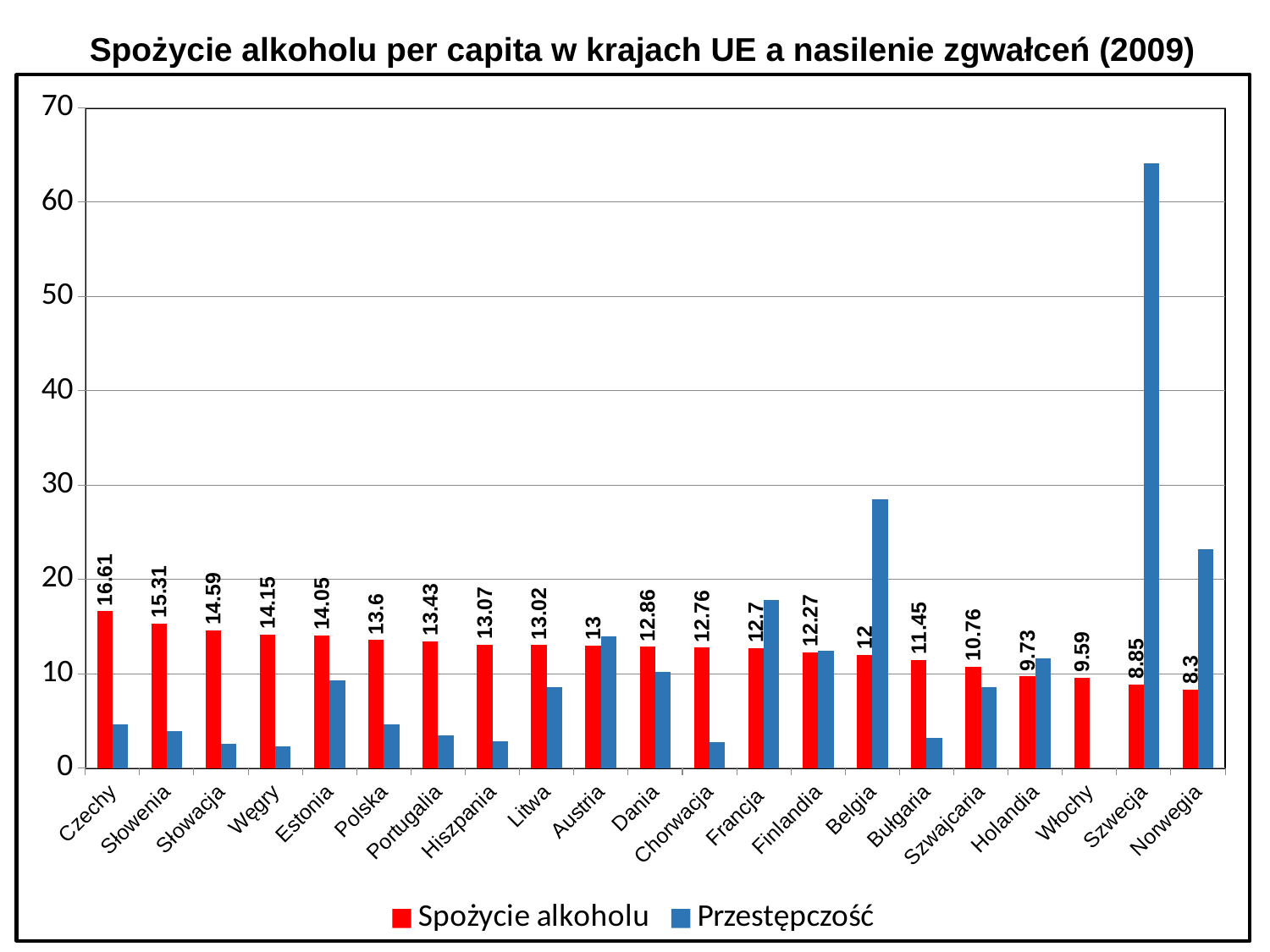
How many series does the legend list? 2 Is the Przestępczość value for Belgia greater or less than 20? greater What is the Spożycie alkoholu value for Czechy? 16.61 Which has a higher Spożycie alkoholu value, Belgia or Bułgaria? Belgia Which country has the highest Przestępczość value? Szwecja Which country has the lowest Spożycie alkoholu value? Norwegia What is the difference between the Spożycie alkoholu values for Czechy and Norwegia? 8.31 Do the Spożycie alkoholu values rise or fall from left to right along the x axis? fall What is the Spożycie alkoholu value for Polska? 13.6 Which country has the highest Spożycie alkoholu value? Czechy Is the Przestępczość value for Szwecja greater or less than 60? greater How many countries are shown on the x axis? 21